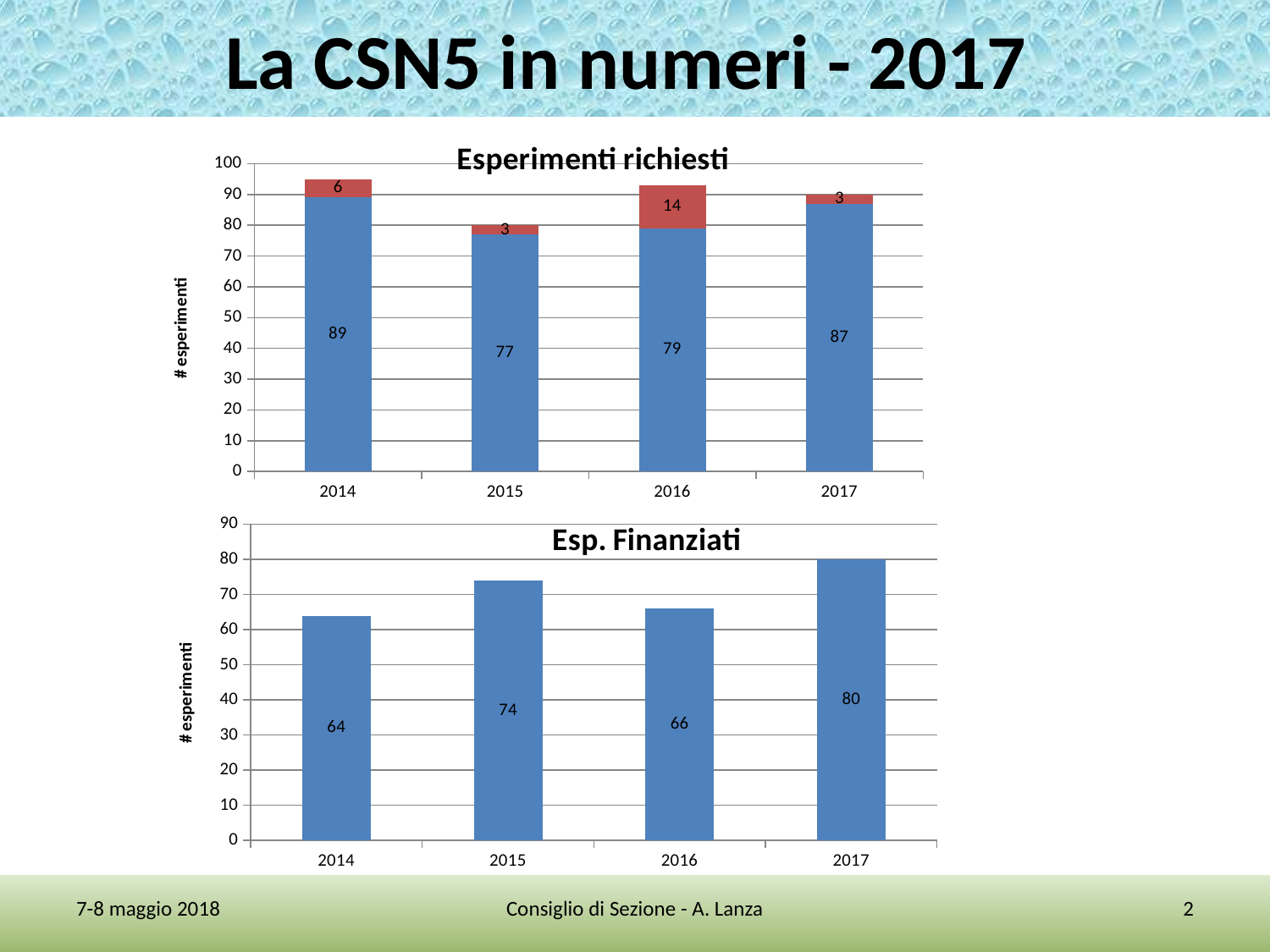
In the 'Esp. Finanziati' chart, which year has the lowest value? 2014 In the 'Esp. Finanziati' chart, which year has the highest value? 2017 In the 'Esperimenti richiesti' chart, which year has the lowest blue segment value? 2015 In the 'Esperimenti richiesti' chart, what is the total of the stacked bar for 2016? 93 In the 'Esp. Finanziati' chart, what is the difference between the values for 2015 and 2016? 8 In the 'Esperimenti richiesti' chart, what is the total of the stacked bar for 2014? 95 In the 'Esperimenti richiesti' chart, what is the value of the blue segment for 2014? 89 In the 'Esp. Finanziati' chart, how many years are shown on the x axis? 4 What type of chart is the 'Esp. Finanziati' chart? Bar chart In the 'Esp. Finanziati' chart, what is the value for 2017? 80 In the 'Esperimenti richiesti' chart, what is the value of the red segment for 2016? 14 In the 'Esperimenti richiesti' chart, what is the difference between the blue segment values for 2014 and 2015? 12